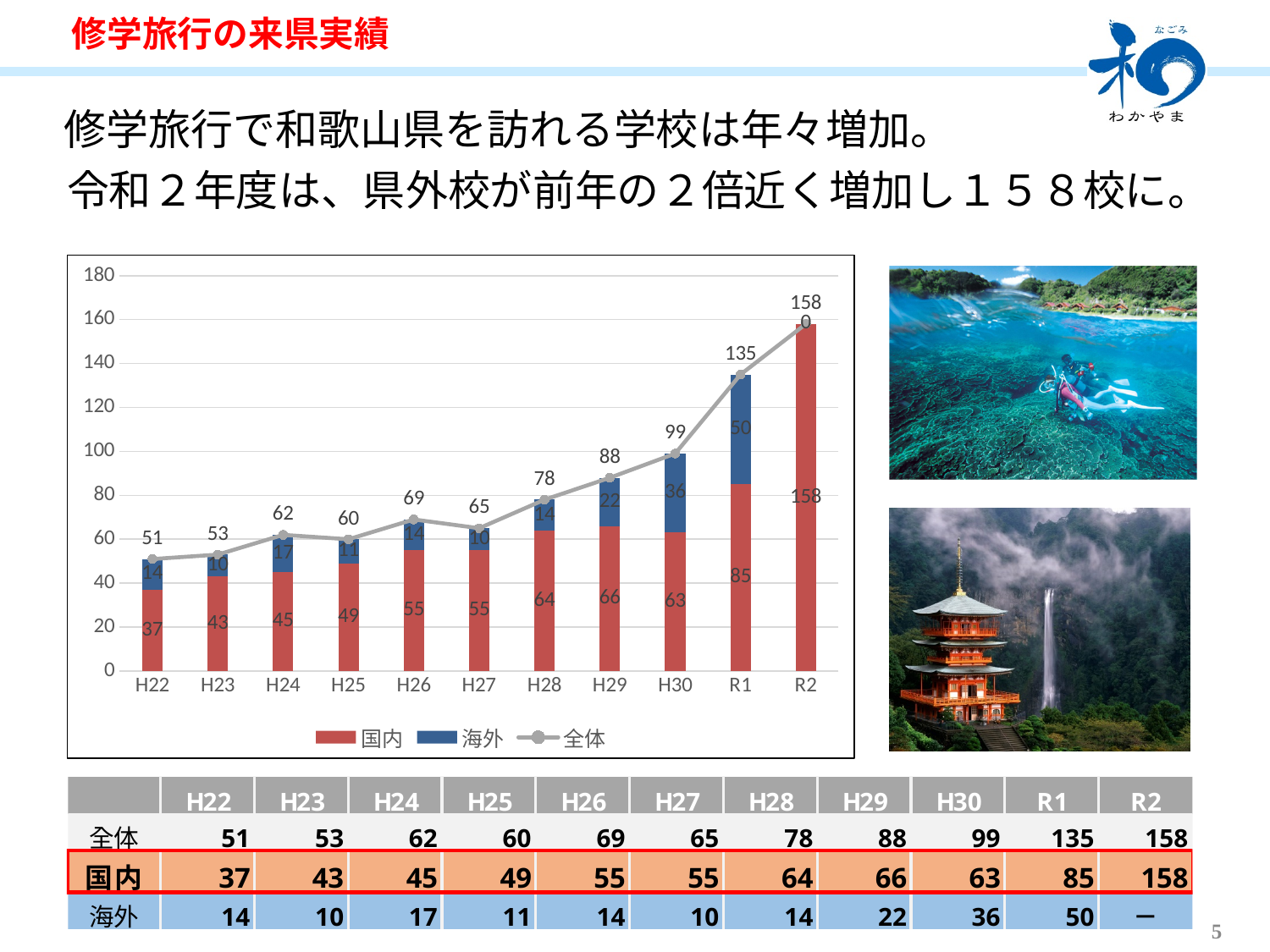
Does the 全体 line generally rise or fall from H22 to R2? Rise What is the value of 全体 for R2? 158 Which year has the highest 全体 value? R2 What kind of chart is this? Stacked bar chart with a line What is the 国内 value for H28? 64 Which year has the lowest 全体 value? H22 Which is larger, the 海外 value for H30 or for H29? H30 What is the 海外 value for R1? 50 What is the total of the stacked bar for H29? 88 How many years are shown on the x axis? 11 How many series does the legend list? 3 What is the difference between the 全体 values for R2 and R1? 23